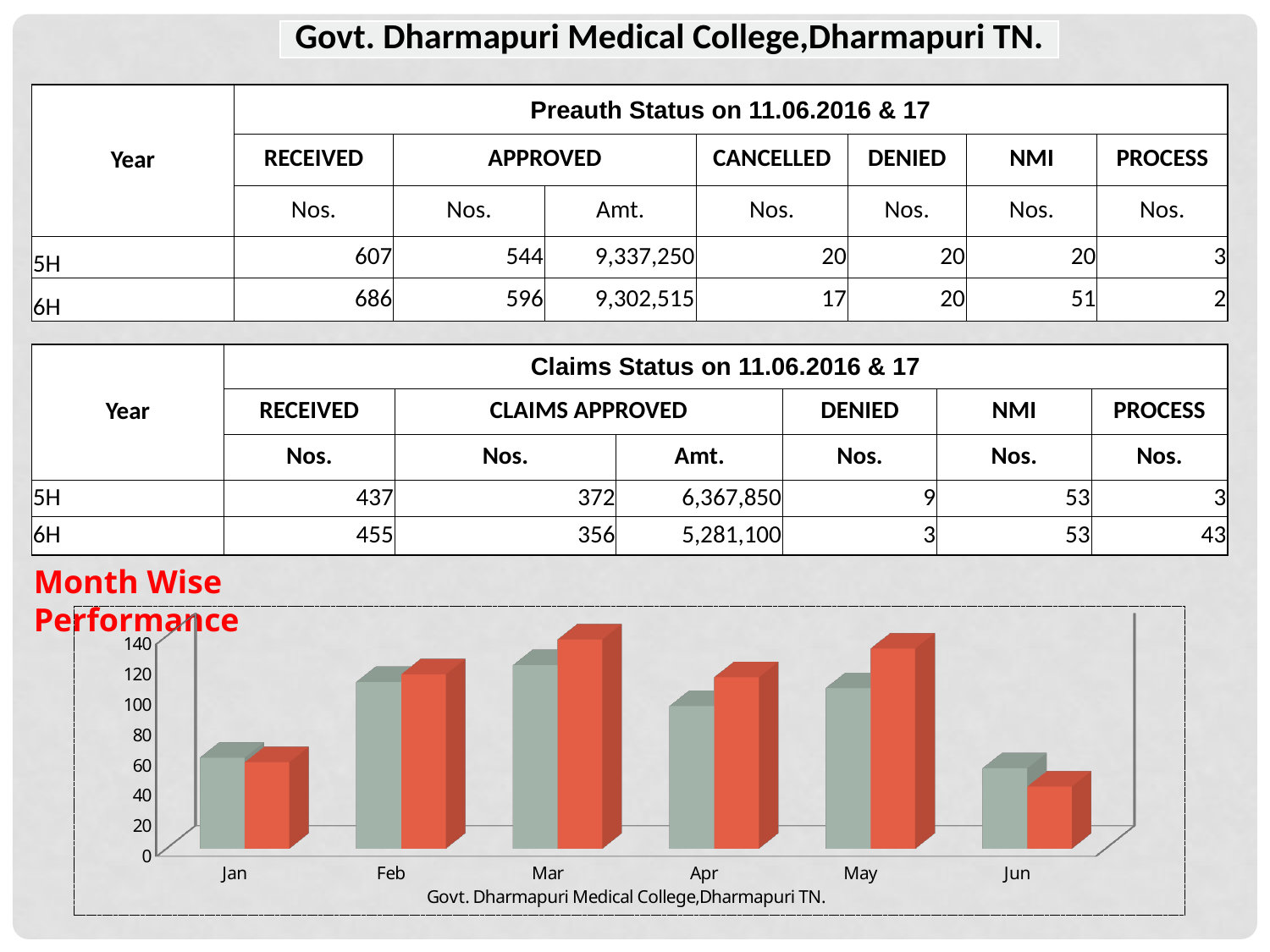
What kind of chart is shown under "Month Wise Performance"? bar chart Which month has the tallest bar in the Month Wise Performance chart? Mar In the Month Wise Performance chart, do the bars rise or fall from Jan to Mar? rise Which month has the shortest bar in the Month Wise Performance chart? Jun What text appears below the x axis of the Month Wise Performance chart? Govt. Dharmapuri Medical College,Dharmapuri TN. In the Month Wise Performance chart, is the grey bar for Jan greater or less than 100? less In the Month Wise Performance chart, is the grey bar for Feb greater or less than 80? greater What is the highest value shown on the vertical axis of the Month Wise Performance chart? 140 How many months are shown on the x axis of the Month Wise Performance chart? 6 In the Month Wise Performance chart, is the red bar for Mar greater or less than 120? greater In the Month Wise Performance chart, which month has the larger red bar, Mar or Jan? Mar